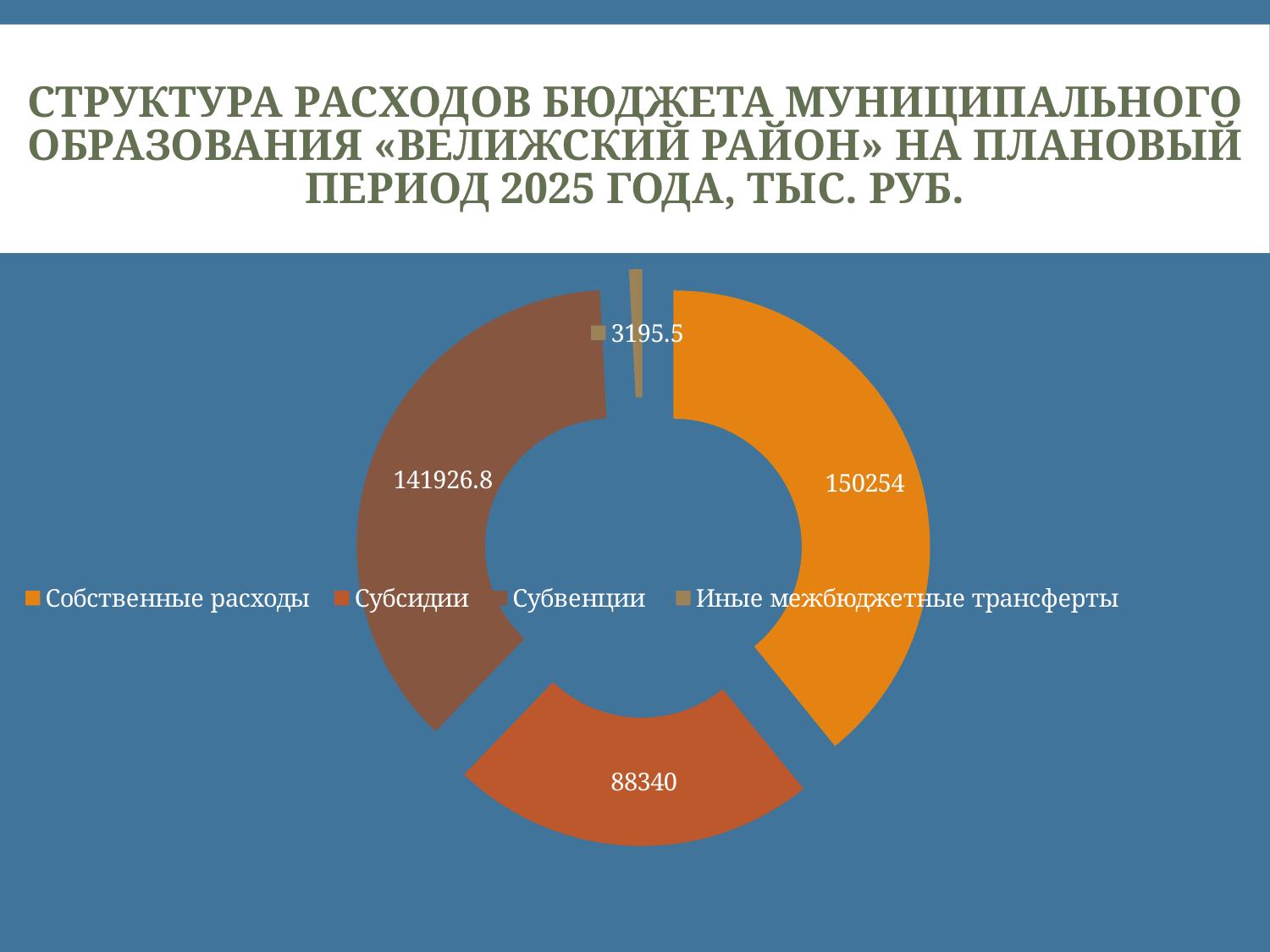
What is the value for Субсидии? 88340 What is the value for Иные межбюджетные трансферты? 3195.5 Which category has the highest value? Собственные расходы What is the value for Субвенции? 141926.8 What is the difference between Собственные расходы and Субвенции? 8327.2 What kind of chart is shown on the slide? doughnut chart How many categories does the chart show? 4 What is the difference between Субвенции and Субсидии? 53586.8 What is the total of all four categories shown in the chart? 383716.3 Which is larger, Субсидии or Субвенции? Субвенции Which category has the lowest value? Иные межбюджетные трансферты What is the value for Собственные расходы? 150254